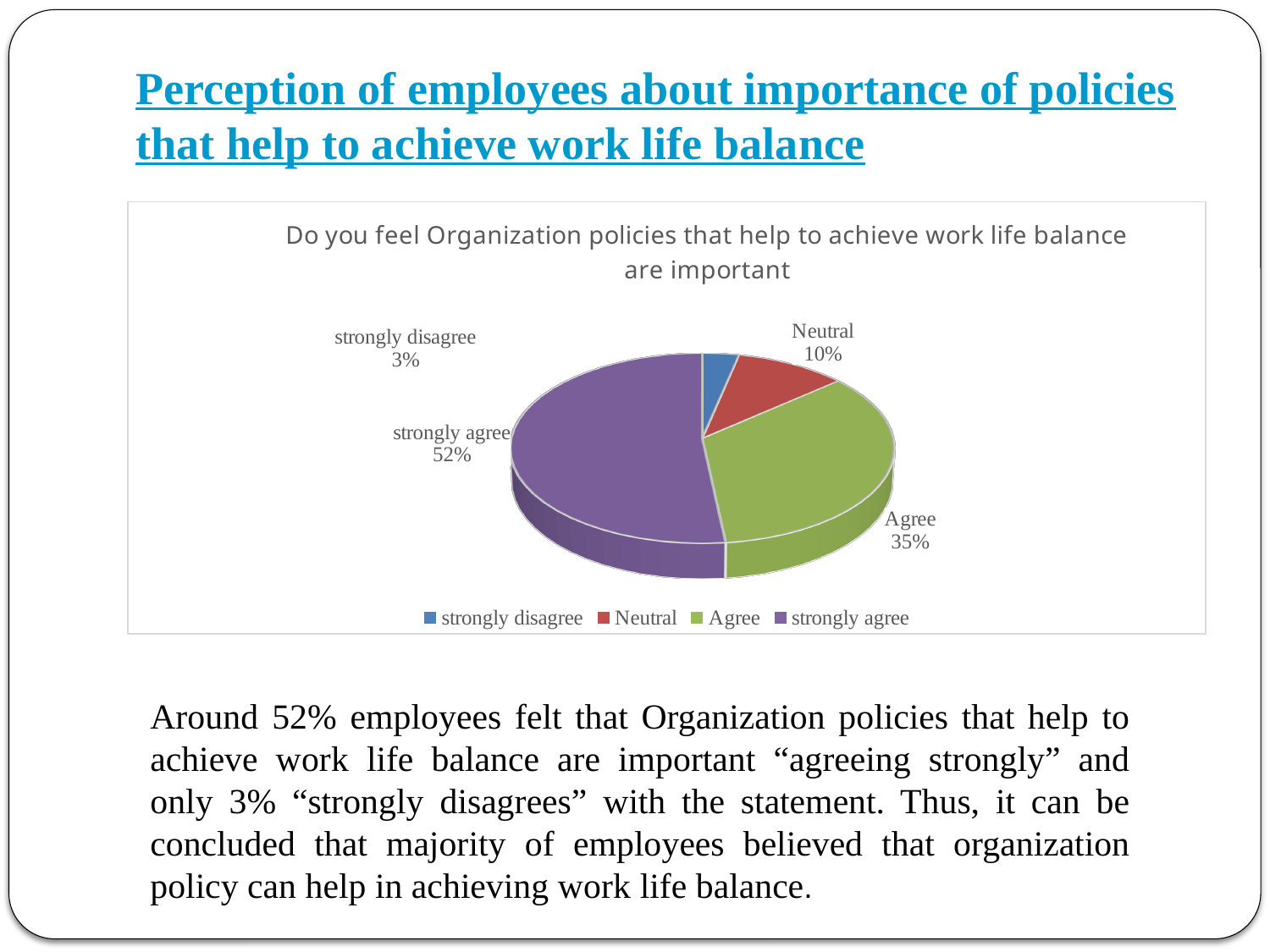
How many response categories are shown in the pie chart? 4 Which response has the largest share of the pie? strongly agree What is the difference in percentage points between "strongly agree" and "Agree"? 17 What percentage of employees answered "strongly agree"? 52% What percentage of employees answered "Agree"? 35% Which response has the smallest share of the pie? strongly disagree How many entries does the legend list? 4 Which is larger, the share for "Neutral" or the share for "Agree"? Agree What colour is the "strongly agree" slice? purple What percentage of employees answered "Neutral"? 10% What kind of chart is shown on the slide? pie chart What percentage of employees answered "strongly disagree"? 3%